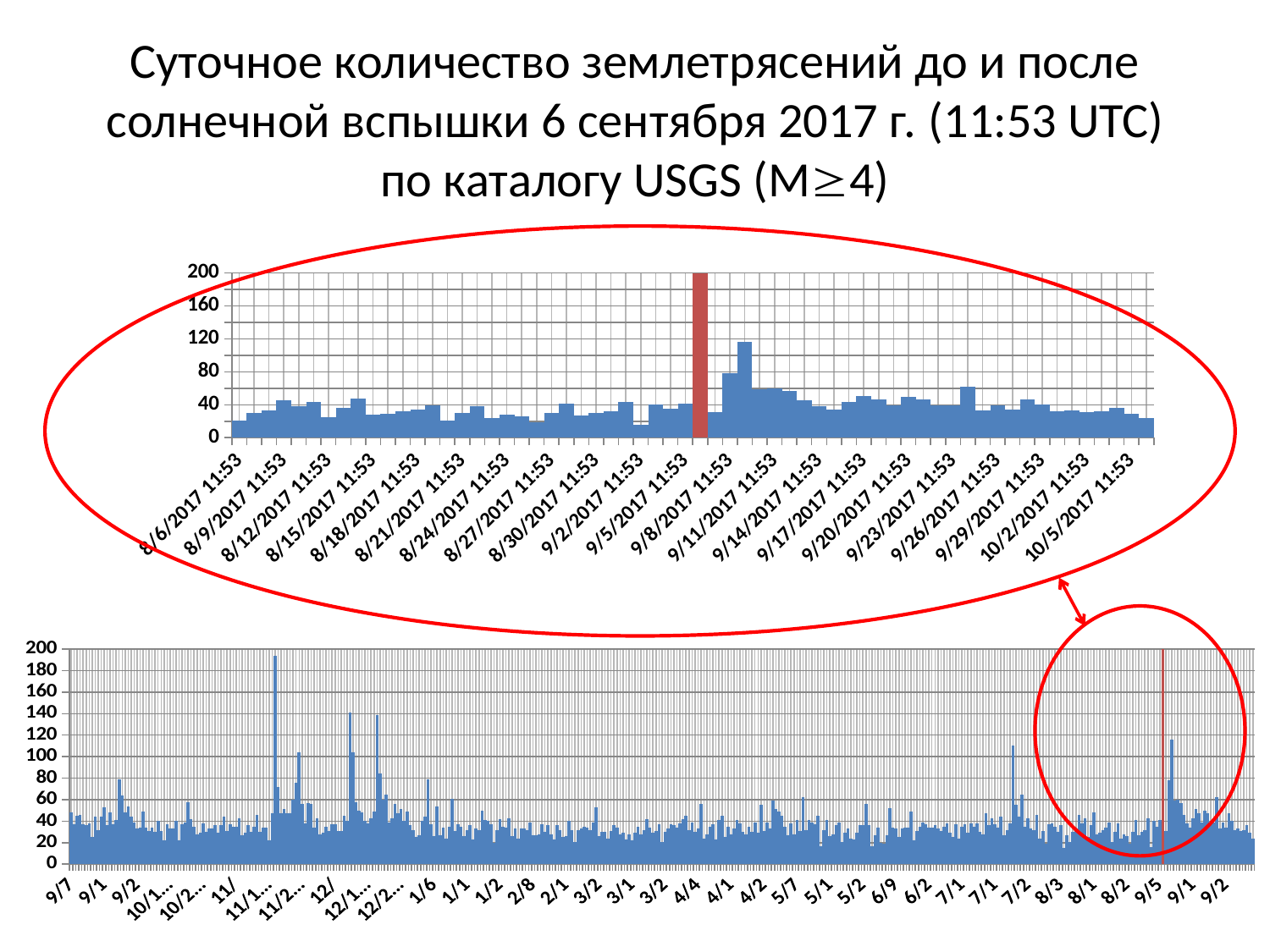
In the top chart, what is the highest value shown on the y axis? 200 In the bottom chart, what is the first label on the x axis? 9/7 In the bottom chart, what is the highest value shown on the y axis? 200 In the bottom chart, is the tallest bar greater or less than 160? greater In the top chart, is the value for 10/5/2017 11:53 greater or less than 40? less In the top chart, does the tallest bar occur before or after the red highlighted bar? after In the top chart, is the value for 8/6/2017 11:53 greater or less than 40? less What kind of chart is the top chart on the slide? bar chart What kind of chart is the bottom chart on the slide? bar chart